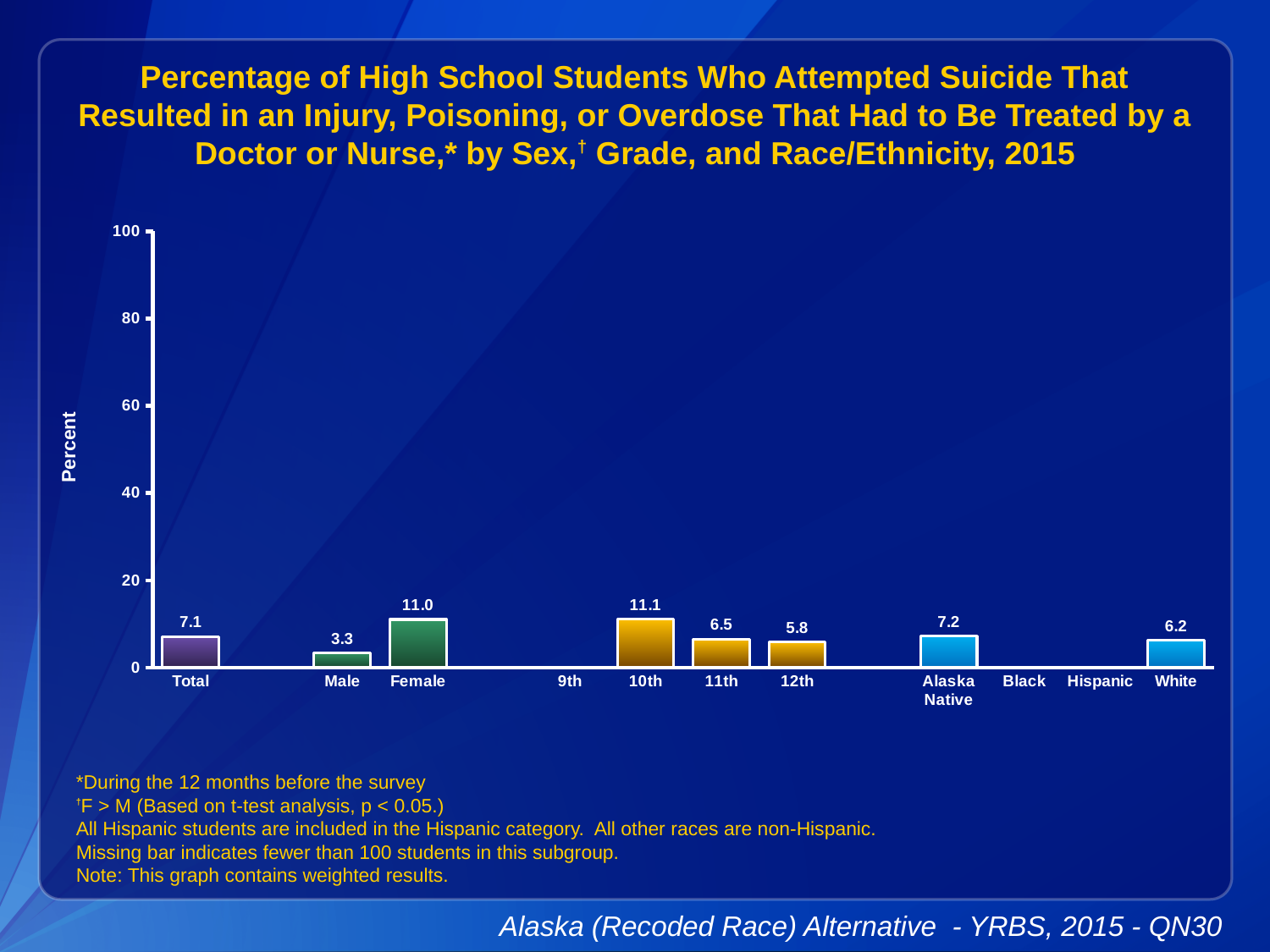
What is the value for Female? 11.0 Which is larger, the value for 11th grade or the value for 12th grade? 11th What is the label on the y axis? Percent How many bars are plotted on the chart? 8 What is the difference between the Female and Male values? 7.7 What kind of chart is shown on the slide? bar chart What is the value for Alaska Native? 7.2 How many category labels are shown on the x axis? 11 Is the value for Total greater or less than 20? less Which category has the lowest value among the bars shown? Male What is the value for 10th grade? 11.1 What is the value for Male? 3.3